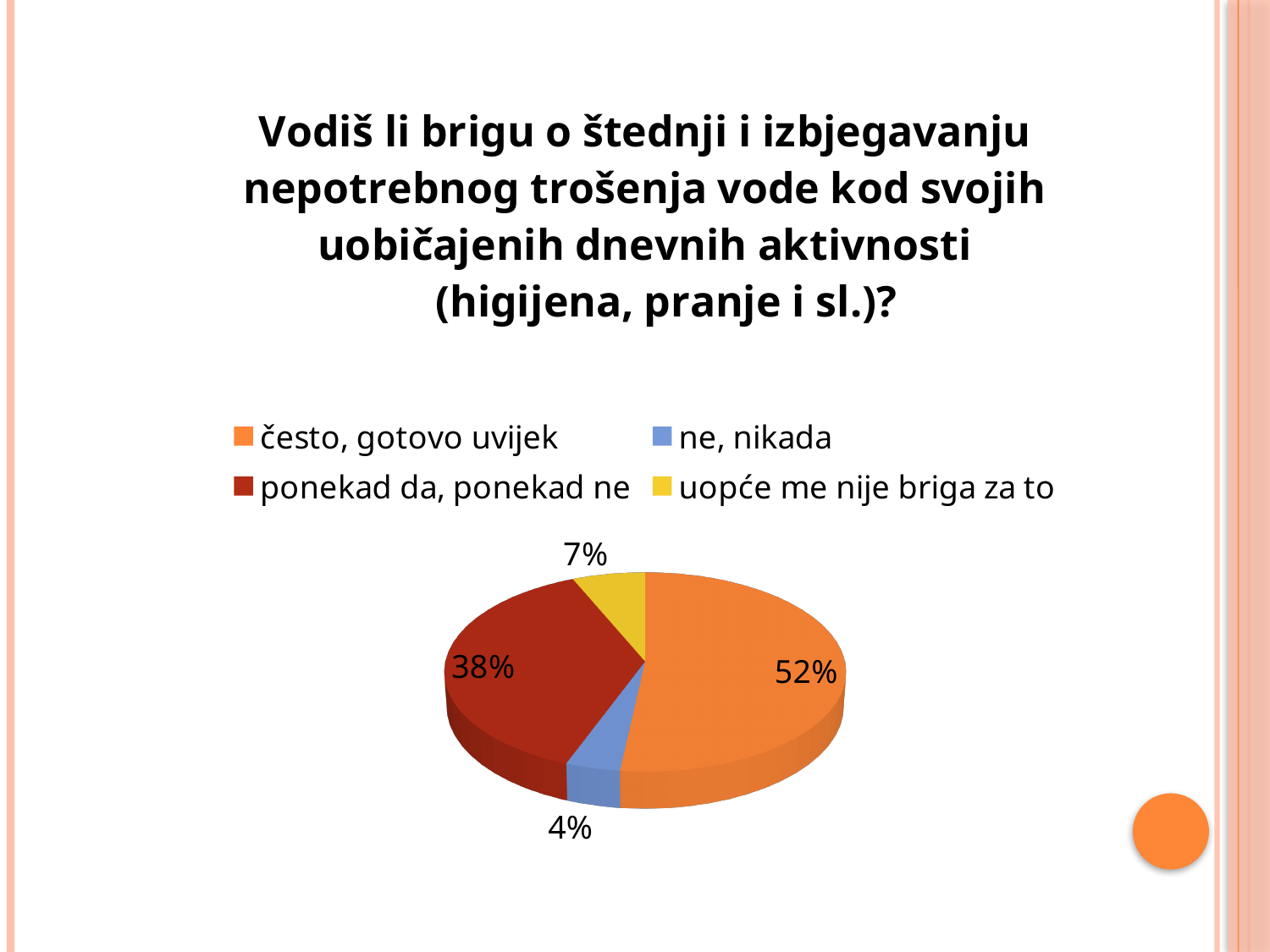
How many slices does the pie chart have? 4 Which is larger: the share for "uopće me nije briga za to" or the share for "ne, nikada"? uopće me nije briga za to What is the difference in percentage points between "često, gotovo uvijek" and "ponekad da, ponekad ne"? 14 What percentage is shown for "ne, nikada"? 4% What colour is the slice for "ponekad da, ponekad ne"? dark red What percentage is shown for "ponekad da, ponekad ne"? 38% What kind of chart is shown on the slide? pie chart Which category has the largest share of the pie? često, gotovo uvijek What percentage of the pie chart is labelled for "često, gotovo uvijek"? 52% What percentage is shown for "uopće me nije briga za to"? 7% How many entries does the legend list? 4 Which category has the smallest share of the pie? ne, nikada